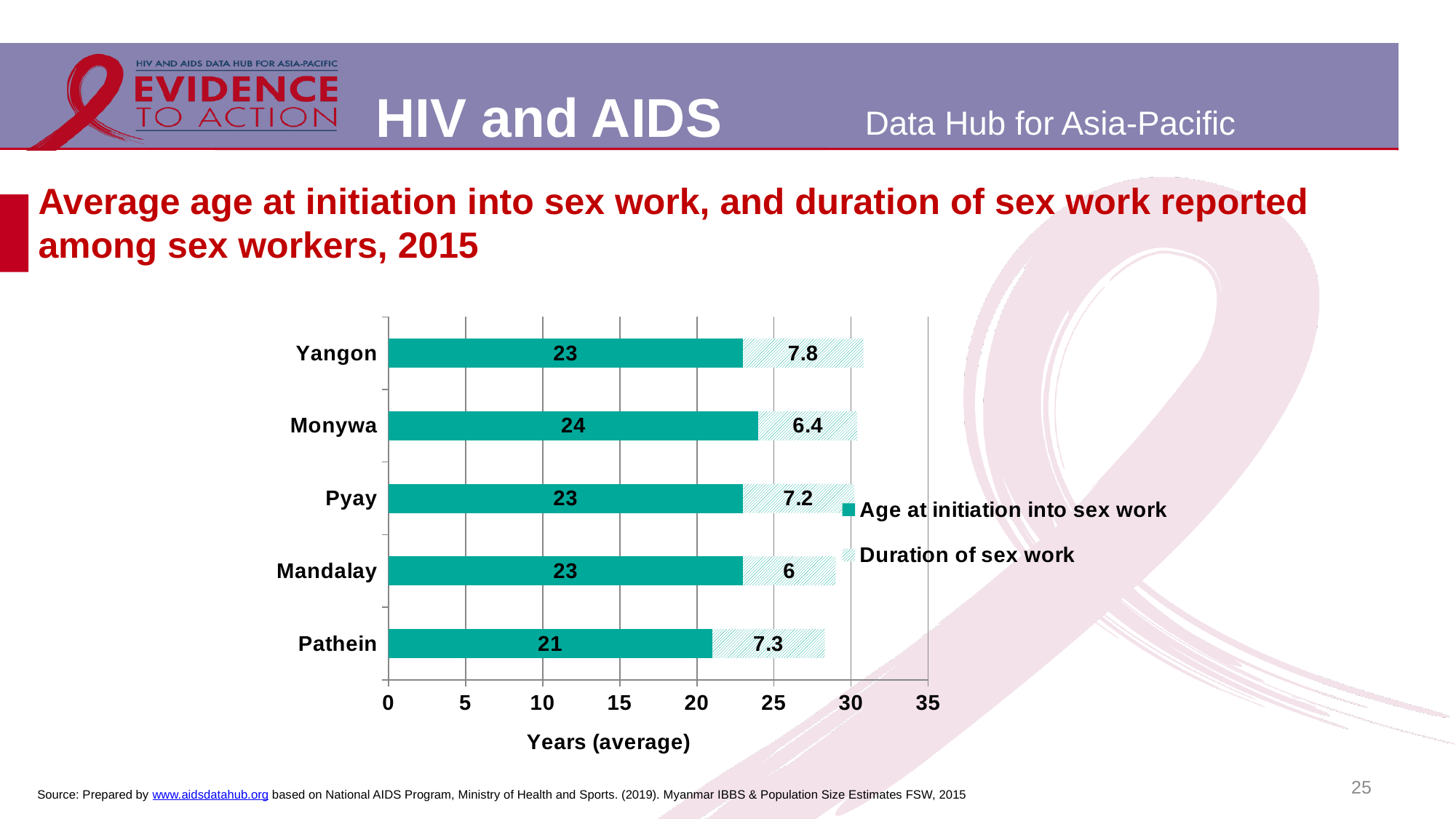
What is the label of the horizontal axis? Years (average) What is the duration of sex work reported for Yangon? 7.8 What is the difference between the duration of sex work in Yangon and in Mandalay? 1.8 What is the average age at initiation into sex work for Monywa? 24 How many series does the legend list? 2 How many cities are shown on the chart? 5 What is the total length of the stacked bar for Pathein (age at initiation plus duration)? 28.3 Which city has the highest duration of sex work? Yangon What is the duration of sex work reported for Mandalay? 6 Which city has the lowest average age at initiation into sex work? Pathein Which is larger, the duration of sex work in Pyay or in Monywa? Pyay What kind of chart is shown on the slide? Stacked bar chart